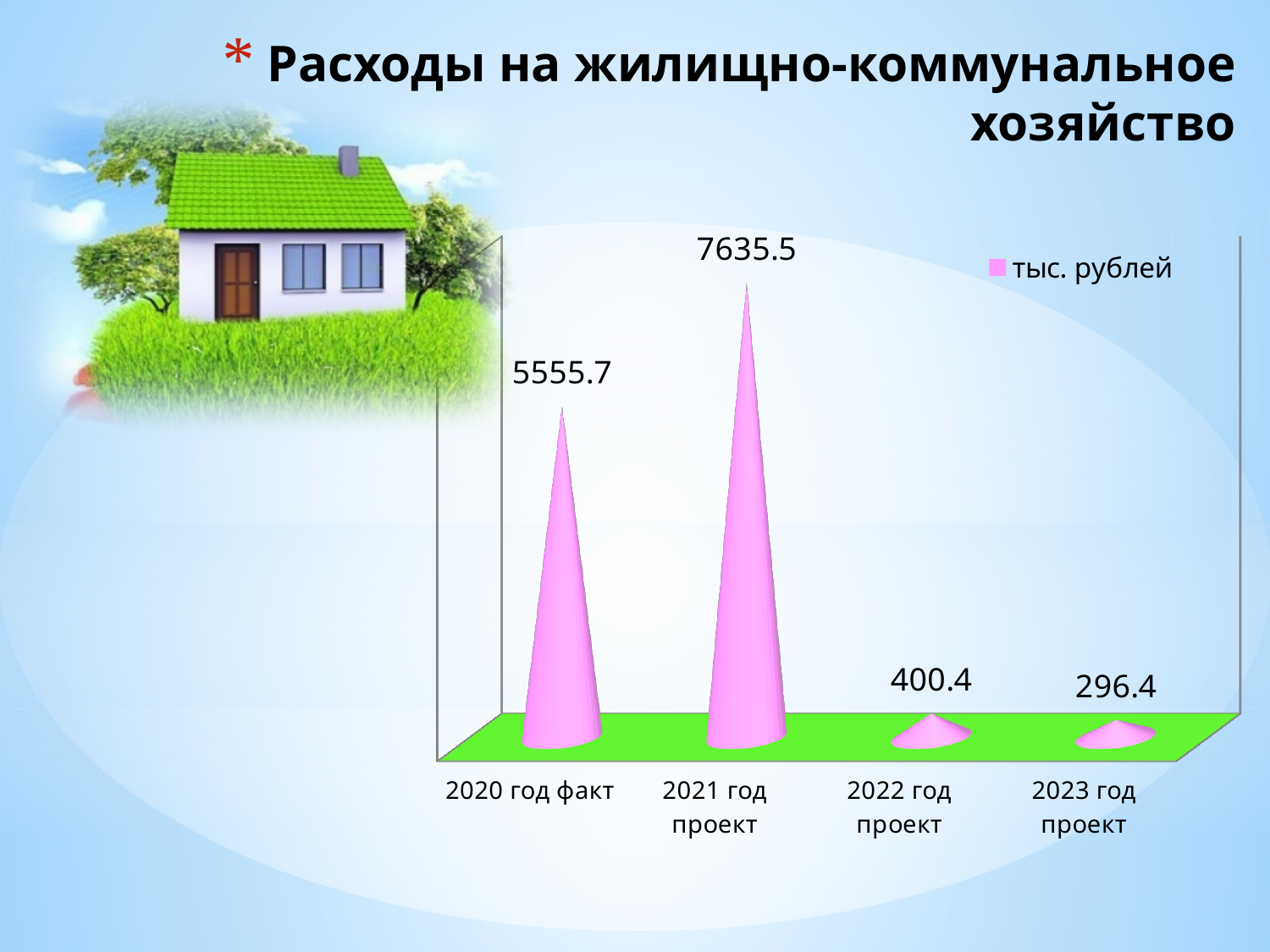
Which is larger, the value for 2020 год факт or the value for 2022 год проект? 2020 год факт What is the value for 2023 год проект? 296.4 What is the difference between the values for 2022 год проект and 2023 год проект? 104.0 How many categories are shown on the x axis? 4 What is the title of the chart? Расходы на жилищно-коммунальное хозяйство What is the value for 2021 год проект? 7635.5 What is the difference between the values for 2021 год проект and 2020 год факт? 2079.8 What is the value for 2022 год проект? 400.4 Which category has the highest value? 2021 год проект How many series does the legend list? 1 What is the value for 2020 год факт? 5555.7 Which category has the lowest value? 2023 год проект